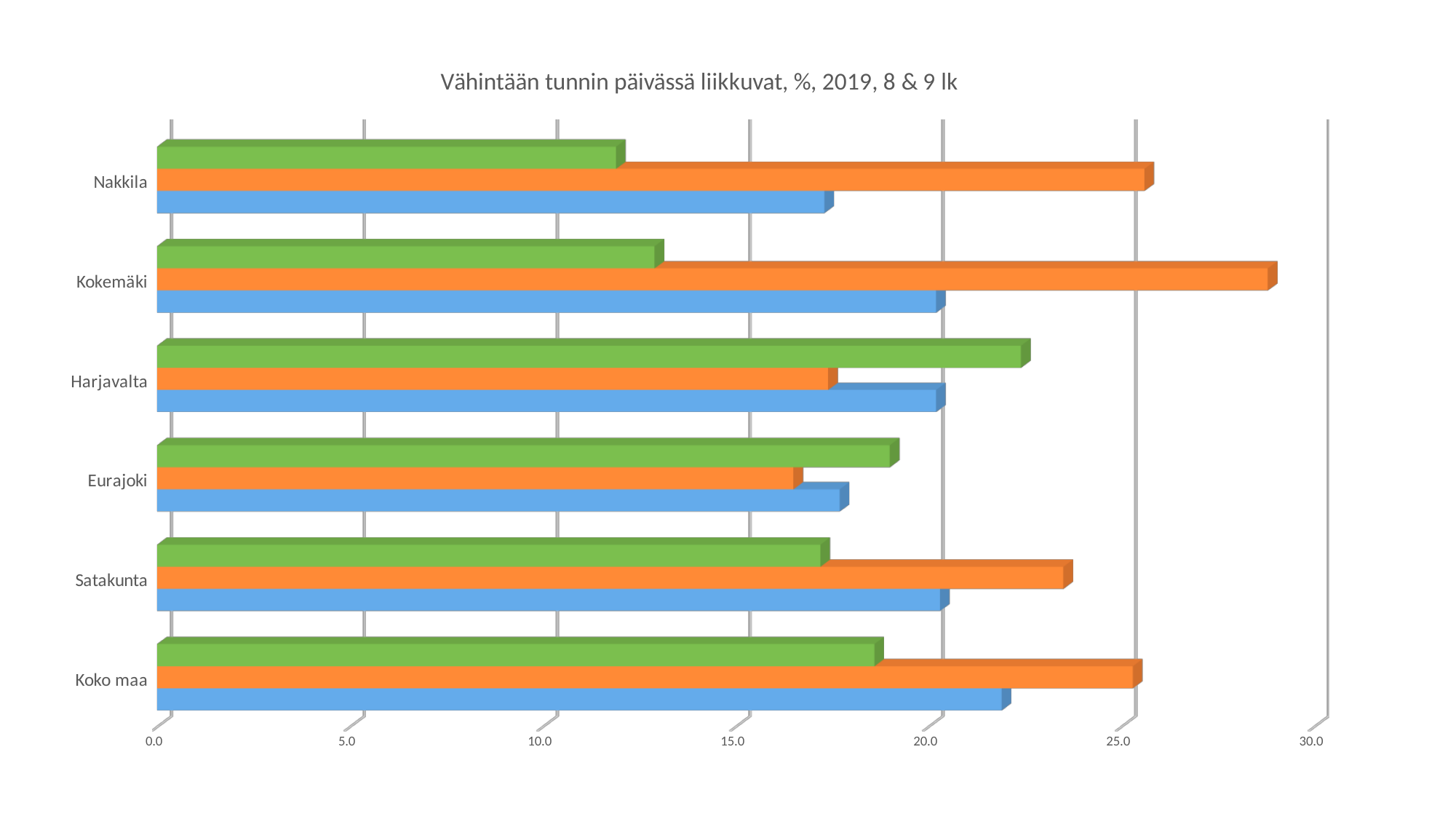
Is the orange bar for Eurajoki greater or less than 20.0? less Is the orange bar for Kokemäki greater or less than 25.0? greater Is the blue bar for Koko maa greater or less than 20.0? greater Which category has the shortest green bar? Nakkila What is the title of the chart? Vähintään tunnin päivässä liikkuvat, %, 2019, 8 & 9 lk Which is longer, the orange bar for Satakunta or the orange bar for Eurajoki? Satakunta Which category has the longest green bar? Harjavalta For Harjavalta, which bar is longer, the green bar or the orange bar? green What kind of chart is shown on the slide? bar chart How many categories are shown on the vertical axis of the chart? 6 Which category has the longest orange bar? Kokemäki